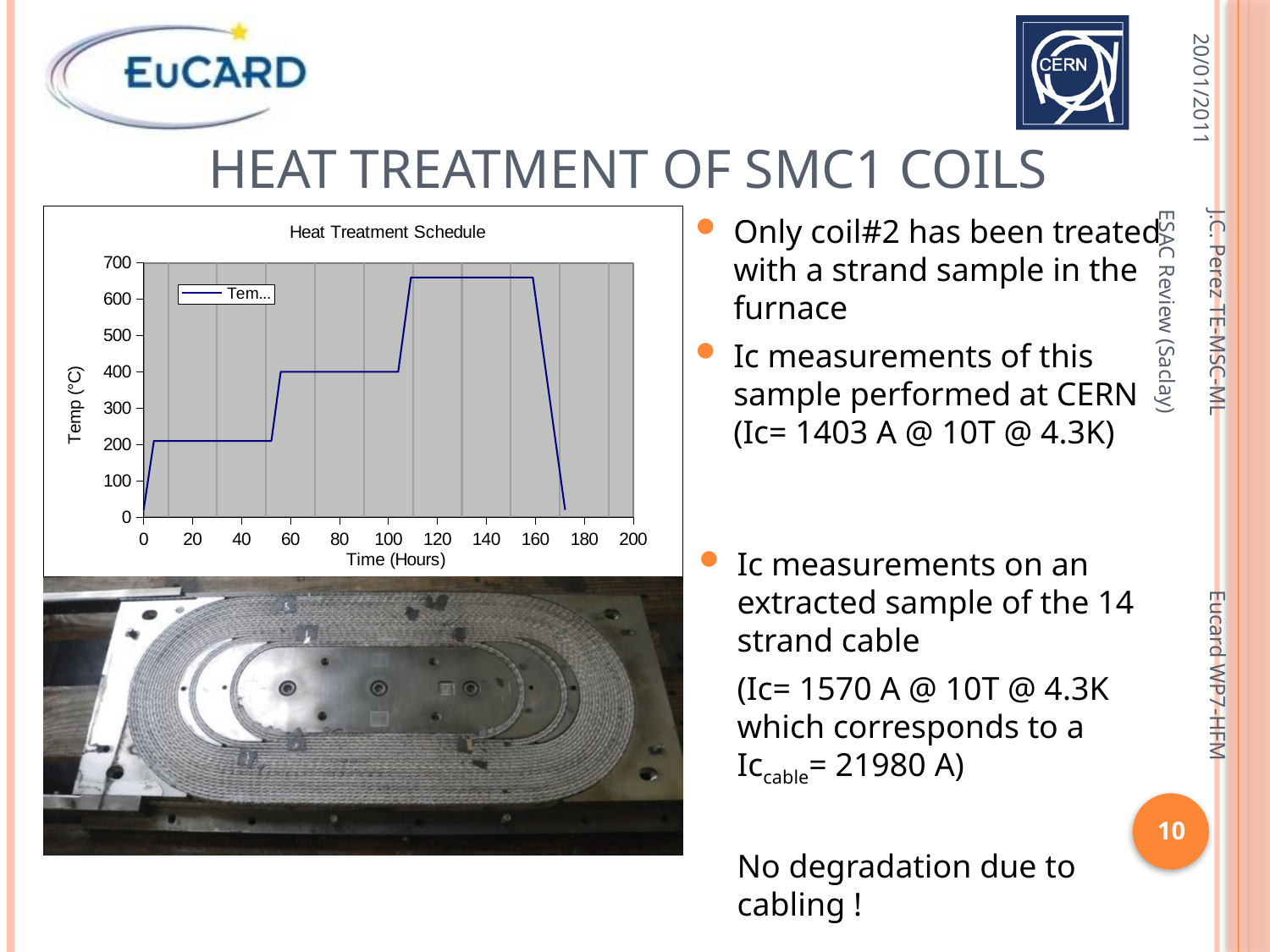
In the Heat Treatment Schedule chart, is the temperature at 40 hours greater or less than 300? less In the Heat Treatment Schedule chart, is the temperature at 120 hours greater or less than 600? greater In the Heat Treatment Schedule chart, is the temperature at 80 hours greater or less than 500? less How many series does the legend of the Heat Treatment Schedule chart list? 1 What kind of chart is the Heat Treatment Schedule chart? line chart What is the title of the chart on the slide? Heat Treatment Schedule In the Heat Treatment Schedule chart, does the temperature rise or fall between 160 and 170 hours? fall In the Heat Treatment Schedule chart, does the temperature rise or fall between 100 and 120 hours? rise What is the label of the x axis of the Heat Treatment Schedule chart? Time (Hours) In the Heat Treatment Schedule chart, is the temperature at 80 hours larger or smaller than the temperature at 120 hours? smaller